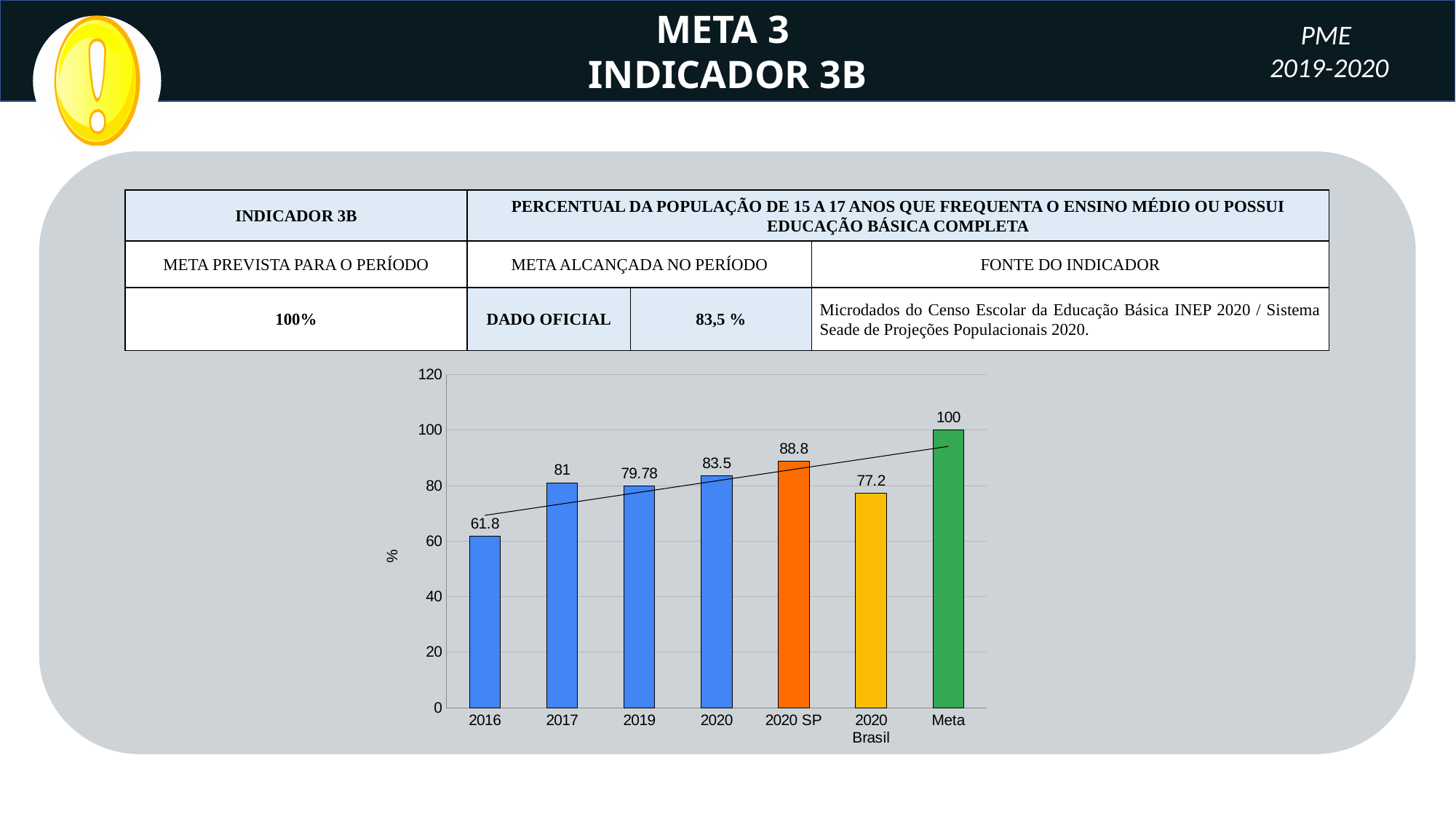
Which category has the lowest value in the bar chart? 2016 What kind of chart is shown on the slide? bar chart How many bars are shown in the chart? 7 What is the value for 2020 Brasil in the bar chart? 77.2 What is the label on the vertical axis of the chart? % Is the value for 2020 Brasil greater or less than 80? less What is the value for 2020 SP in the bar chart? 88.8 Which is larger, the value for 2017 or the value for 2019? 2017 Which category has the highest value in the bar chart? Meta What is the difference between the values for 2020 and 2016? 21.7 What is the difference between the values for 2020 SP and 2020 Brasil? 11.6 What is the value for 2016 in the bar chart? 61.8